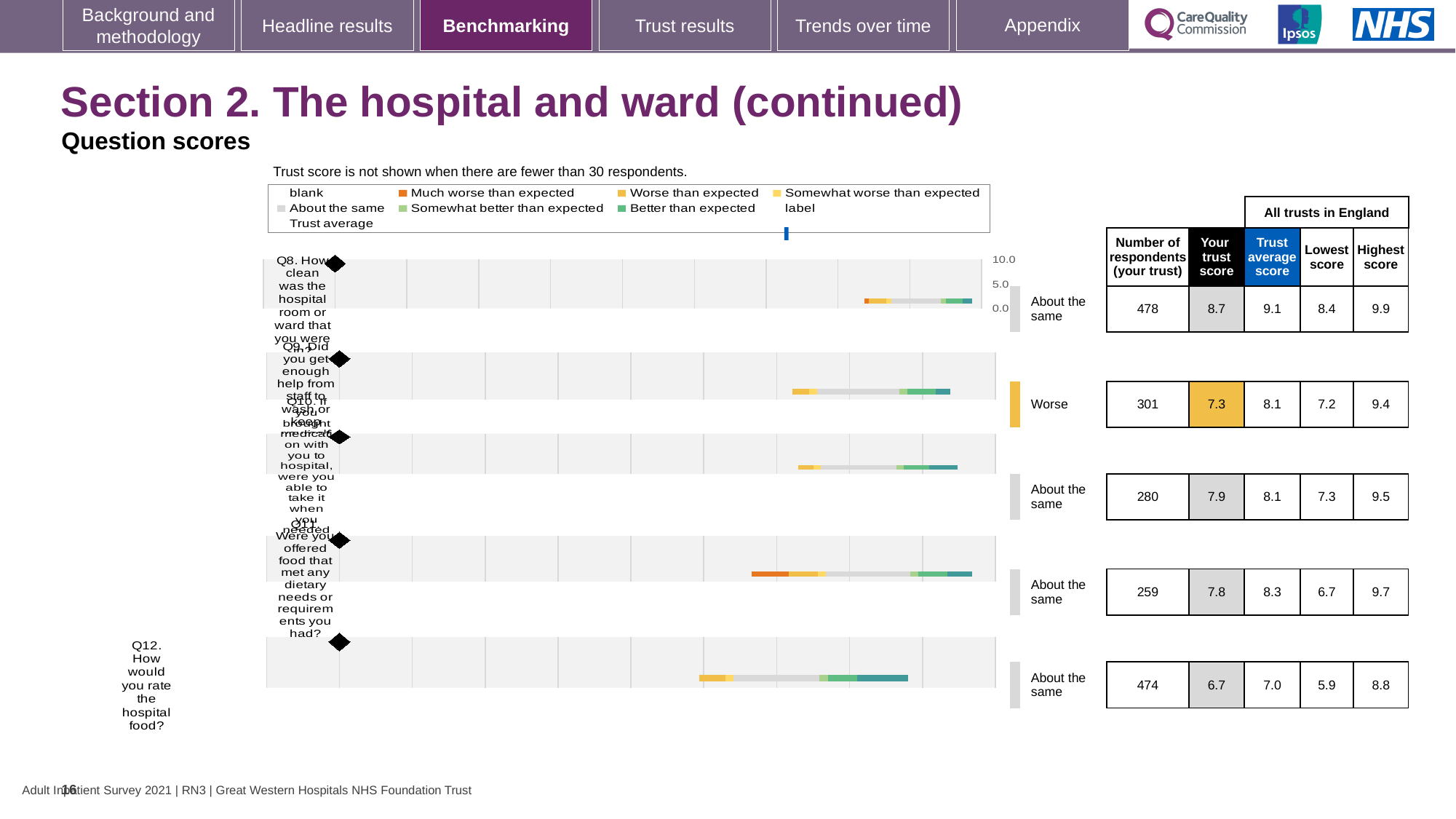
Which question is rated 'Worse' rather than 'About the same' on this slide? Q9 What is the trust average score for Q8? 9.1 Which question has the lowest 'Your trust score' on this slide? Q12 What is the difference between the trust average score and the trust's own score for Q8? 0.4 For Q9, which is larger: the trust's own score or the trust average score? Trust average score What is the trust's score for Q8 (how clean was the hospital room or ward)? 8.7 What kind of chart is used to show the question scores on this slide? bar chart What is the highest score across all trusts in England for Q11? 9.7 What is the lowest score across all trusts in England for Q12? 5.9 How many questions (bars) are plotted in the question scores chart? 5 How many respondents answered Q12 (how would you rate the hospital food) at this trust? 474 Which question has the highest 'Your trust score' on this slide? Q8